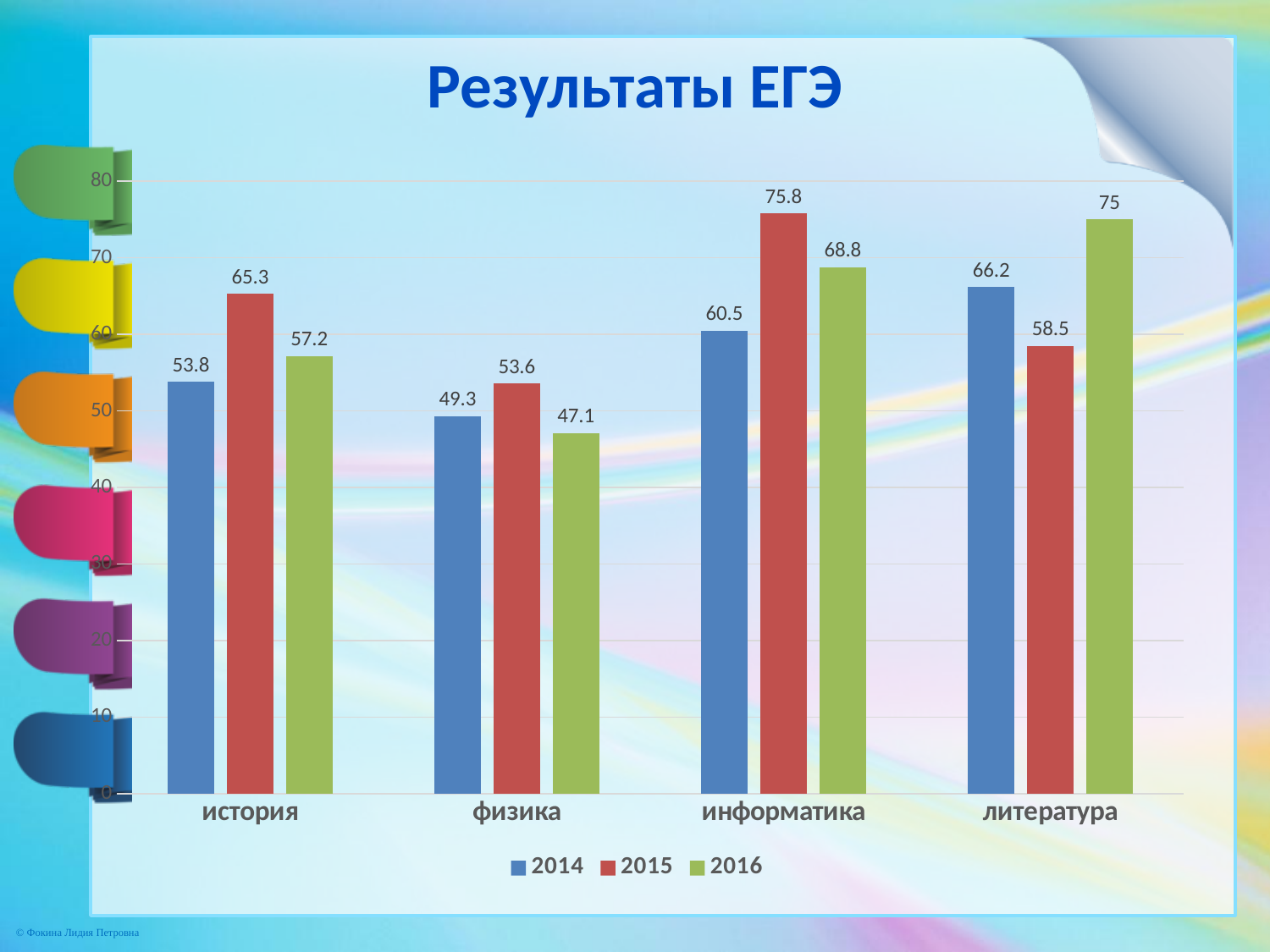
How many series does the legend list? 3 What is the value for информатика in 2015? 75.8 What kind of chart is shown on the slide? bar chart What is the value for литература in 2014? 66.2 How many categories are shown on the x axis? 4 Which is larger for литература: the 2015 value or the 2016 value? 2016 What is the value for физика in 2016? 47.1 What is the difference between the 2015 and 2014 values for история? 11.5 Which category has the lowest value in the 2014 series? физика What is the title of the chart? Результаты ЕГЭ Which category has the highest value in the 2016 series? литература Is the value for информатика in 2014 greater or less than 70? less